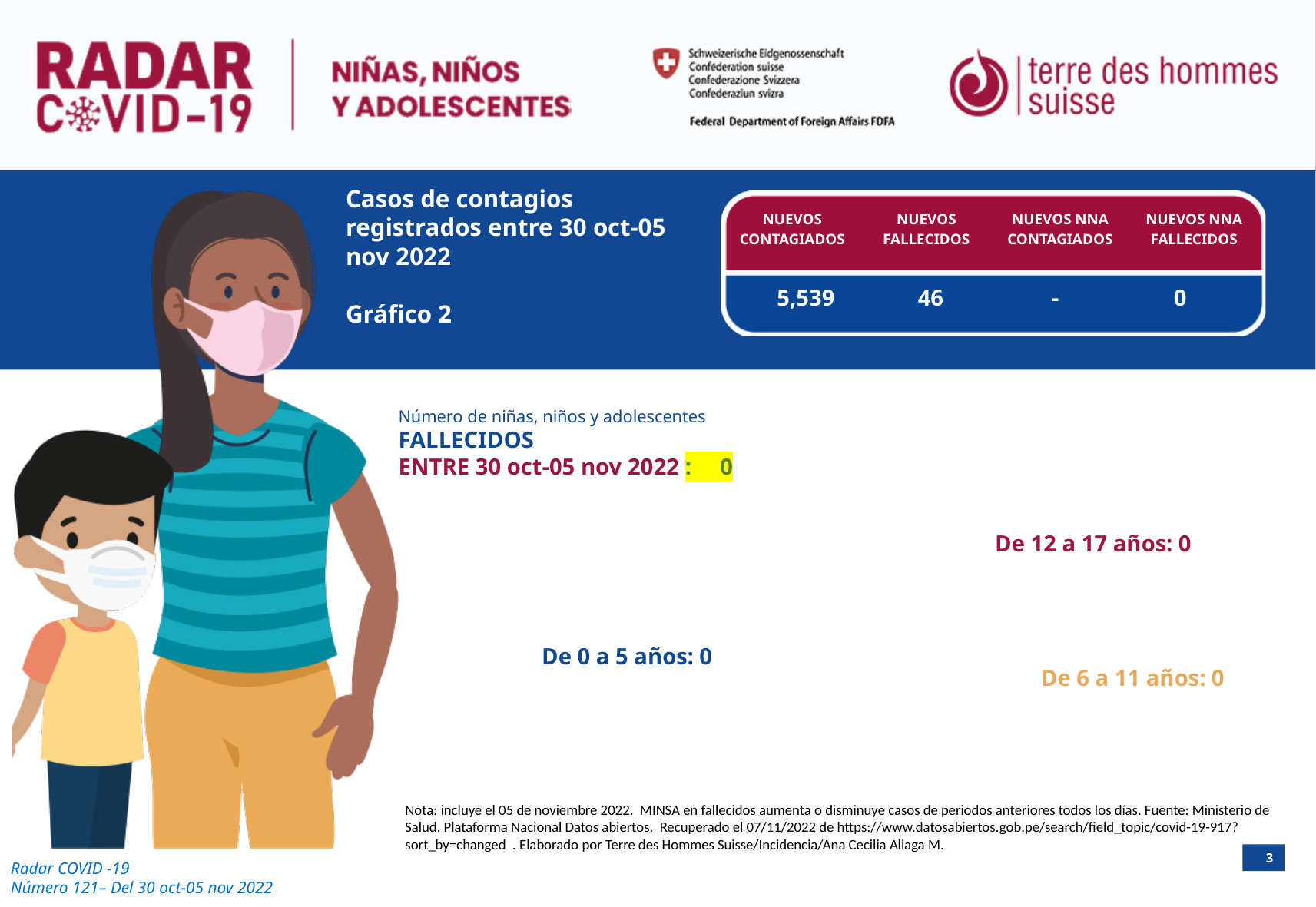
In Gráfico 2, what is the value for the age group 'De 0 a 5 años'? 0 What does Gráfico 2 measure, according to the text above the age-group labels? Número de niñas, niños y adolescentes fallecidos How many age-group categories are labelled in Gráfico 2? 3 What is the total number of niñas, niños y adolescentes fallecidos shown for the period 30 oct-05 nov 2022 in Gráfico 2? 0 In Gráfico 2, what is the difference between the values for 'De 12 a 17 años' and 'De 0 a 5 años'? 0 What period does Gráfico 2 cover, according to its title? 30 oct-05 nov 2022 In Gráfico 2, what is the value for the age group 'De 6 a 11 años'? 0 In Gráfico 2, what is the value for the age group 'De 12 a 17 años'? 0